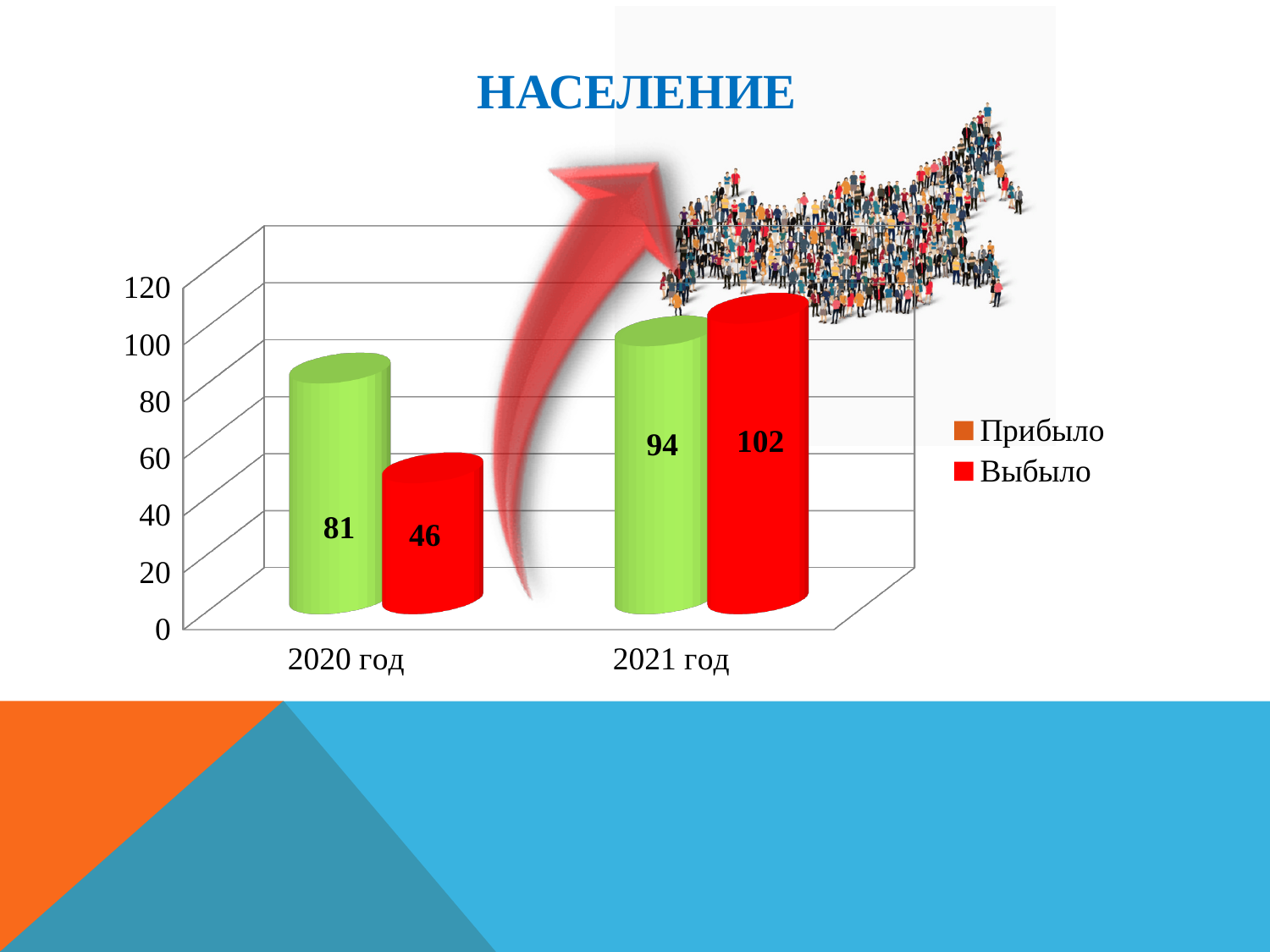
What is the value for Прибыло in 2020 год? 81 What is the title of the chart? НАСЕЛЕНИЕ What is the value for Выбыло in 2020 год? 46 How many series does the legend list? 2 What is the value for Выбыло in 2021 год? 102 Which is larger in 2021 год, Прибыло or Выбыло? Выбыло Which bar has the highest value on the chart? Выбыло in 2021 год What is the value for Прибыло in 2021 год? 94 What is the difference between Прибыло and Выбыло in 2020 год? 35 Which bar has the lowest value on the chart? Выбыло in 2020 год What is the difference between Выбыло in 2021 год and Выбыло in 2020 год? 56 What kind of chart is shown on the slide? Bar chart